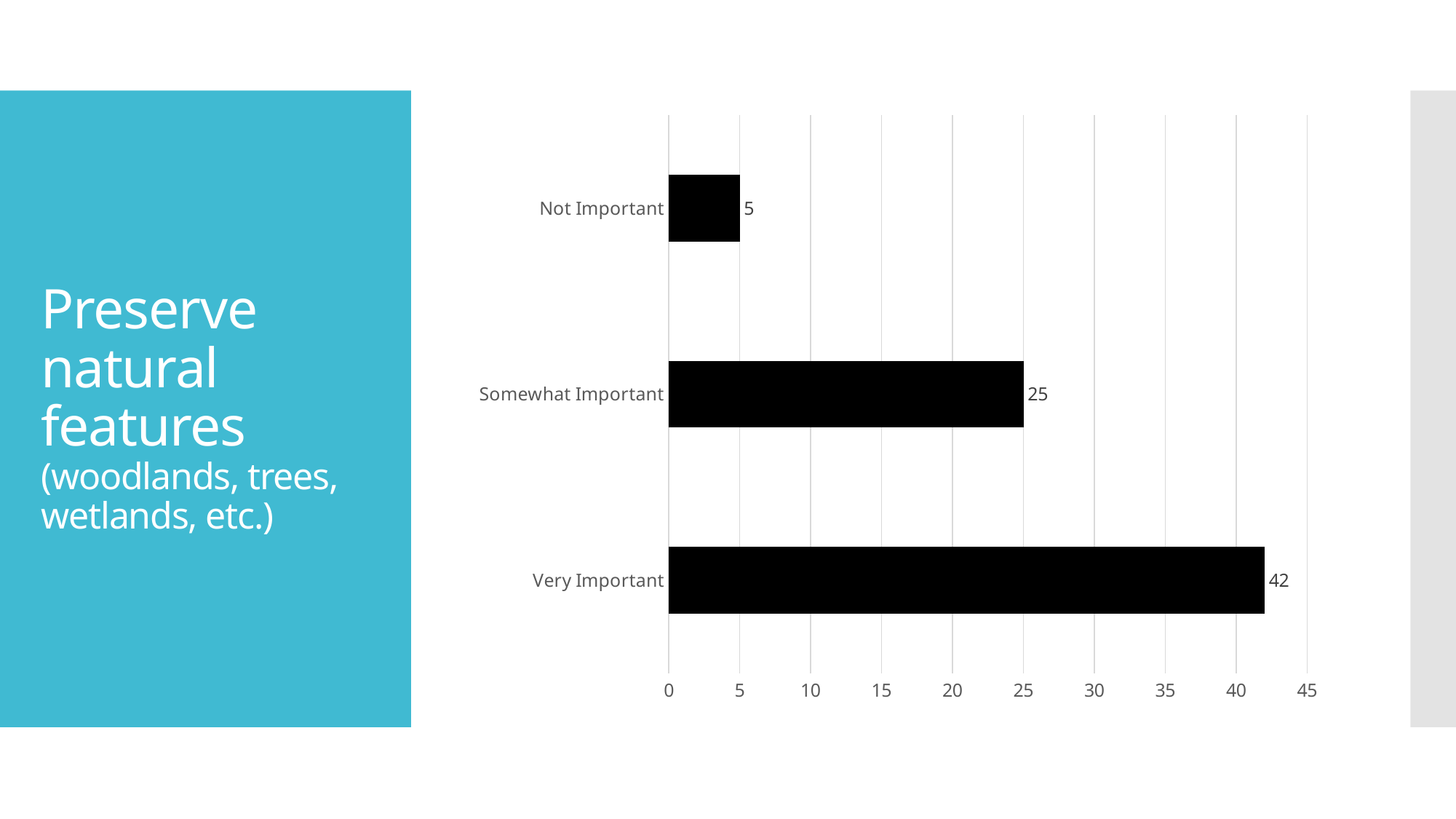
What is the difference between the values for Very Important and Somewhat Important? 17 What kind of chart is shown on the slide? bar chart What is the value for Somewhat Important? 25 What is the value for Very Important? 42 What is the value for Not Important? 5 Which category has the lowest value? Not Important What is the total of the three values shown in the chart? 72 How many categories are shown in the chart? 3 Which category has the highest value? Very Important Which is larger, the value for Somewhat Important or the value for Not Important? Somewhat Important Is the value for Very Important greater or less than 40? greater What is the difference between the values for Somewhat Important and Not Important? 20